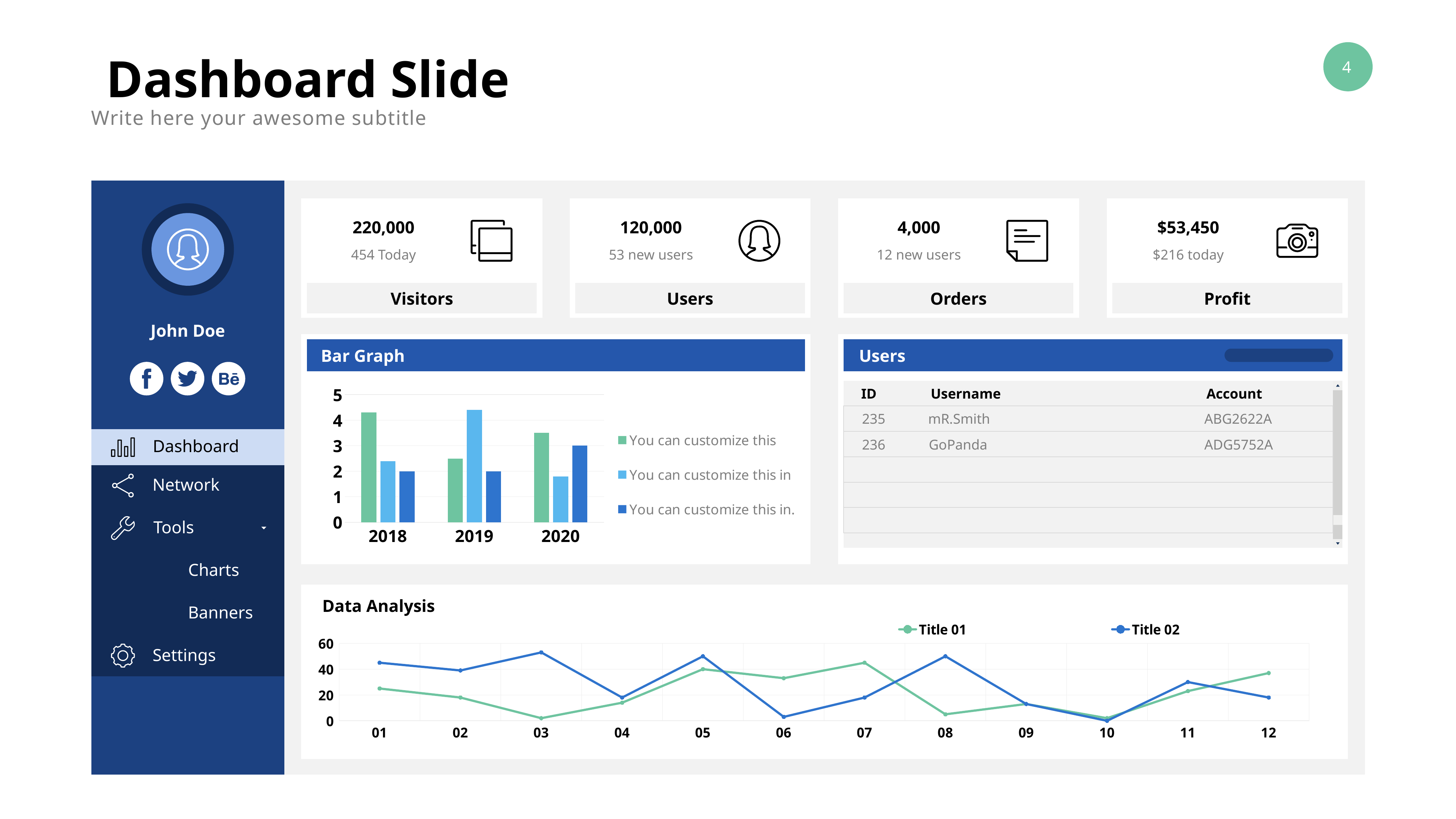
In the Bar Graph chart, for 2019, which bar is taller: the green bar or the light blue bar? the light blue bar In the Data Analysis chart, is the value of Title 01 at 03 greater or less than 20? less What kind of chart is the Data Analysis chart? line chart In the Data Analysis chart, is the value of Title 02 at 03 greater or less than 40? greater In the Data Analysis chart, at point 08, which series has the higher value: Title 01 or Title 02? Title 02 How many series does the legend of the Data Analysis chart list? 2 How many points are shown along the x axis of the Data Analysis chart? 12 How many categories are shown on the x axis of the Bar Graph chart? 3 In the Bar Graph chart, is the value of the green bar for 2018 greater or less than 4? greater What kind of chart is the Bar Graph chart? bar chart How many series does the legend of the Bar Graph chart list? 3